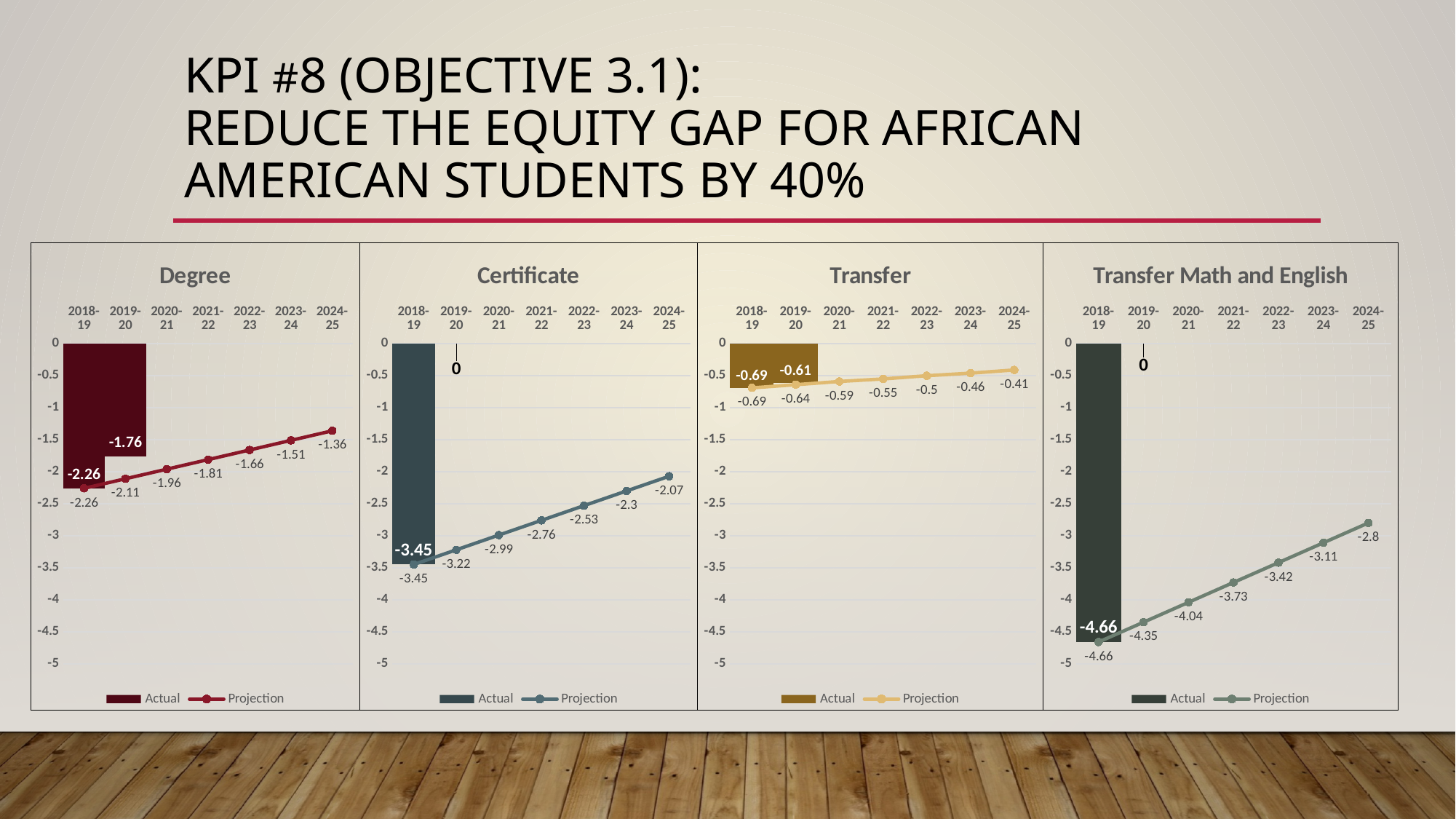
In the Certificate chart, what is the Projection value for 2024-25? -2.07 In the Transfer Math and English chart, what is the Actual value for 2018-19? -4.66 How many year categories are shown on the x axis of the Certificate chart? 7 How many series does the legend list in the Degree chart? 2 In the Transfer chart, what is the Actual value for 2018-19? -0.69 In the Transfer Math and English chart, what is the Projection value for 2021-22? -3.73 In the Certificate chart, which year has the lowest Projection value? 2018-19 In the Degree chart, what is the difference between the Actual values for 2018-19 and 2019-20? 0.5 In the Transfer chart, does the Projection line rise or fall from 2018-19 to 2024-25? rise In the Degree chart, what is the Actual value for 2019-20? -1.76 In the Transfer Math and English chart, is the Projection value for 2020-21 greater or less than -4? less In the Transfer chart, which year has the highest Projection value? 2024-25